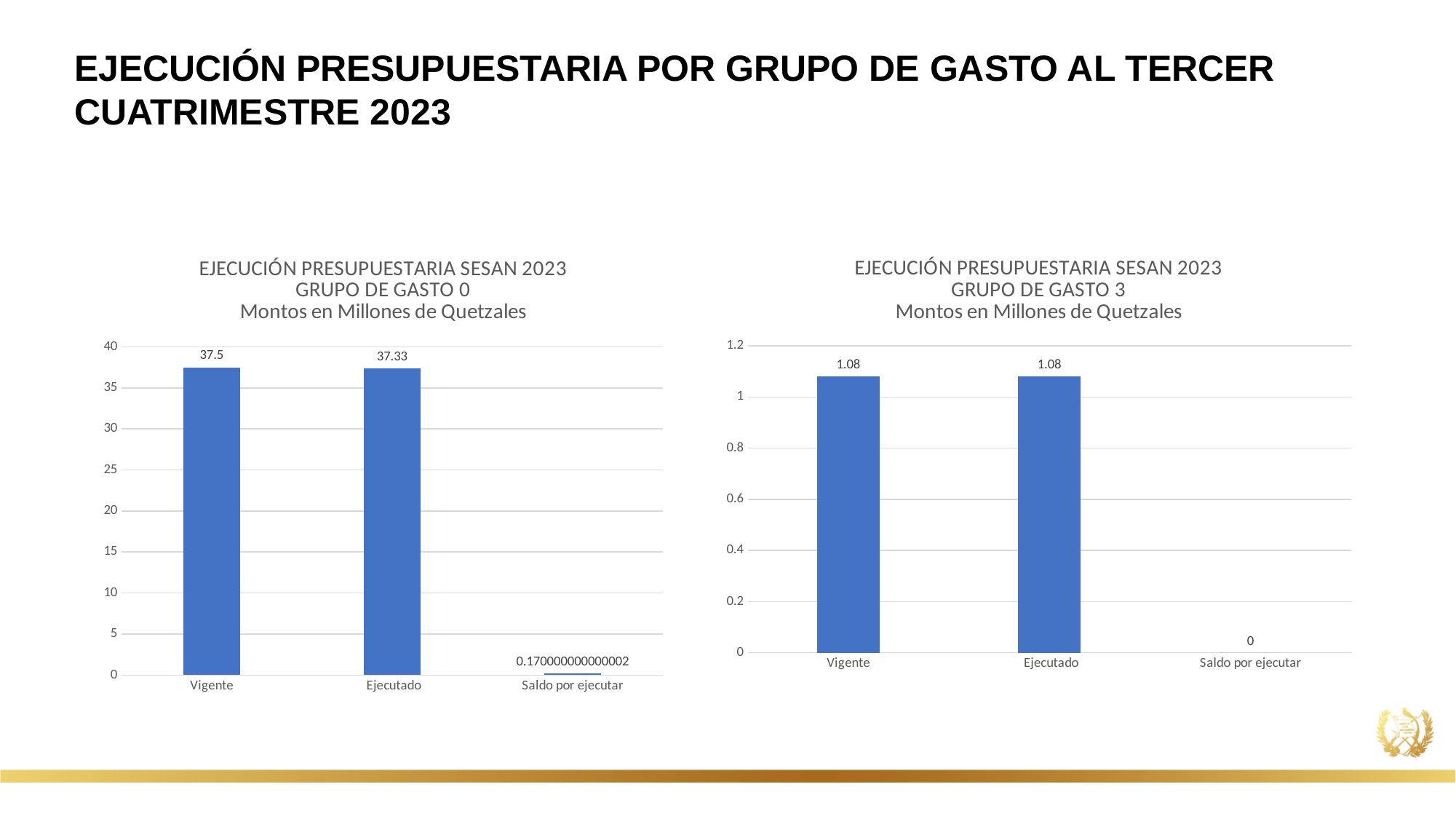
In the GRUPO DE GASTO 3 chart, what is the value for Saldo por ejecutar? 0 In the GRUPO DE GASTO 0 chart, what is the value labelled for Saldo por ejecutar? 0.170000000000002 According to the chart subtitles, in what units are the amounts expressed? Millones de Quetzales In the GRUPO DE GASTO 0 chart, what is the value for Vigente? 37.5 In the GRUPO DE GASTO 0 chart, is the value for Ejecutado greater or less than 35? greater In the GRUPO DE GASTO 3 chart, what is the difference between Vigente and Ejecutado? 0 In the GRUPO DE GASTO 0 chart, how many categories are shown on the x axis? 3 In the GRUPO DE GASTO 0 chart, which category has the lowest value? Saldo por ejecutar In the GRUPO DE GASTO 0 chart, what is the value for Ejecutado? 37.33 What kind of chart is the GRUPO DE GASTO 3 chart? Bar chart In the GRUPO DE GASTO 3 chart, what is the value for Vigente? 1.08 In the GRUPO DE GASTO 3 chart, is the value for Ejecutado greater or less than 1? greater